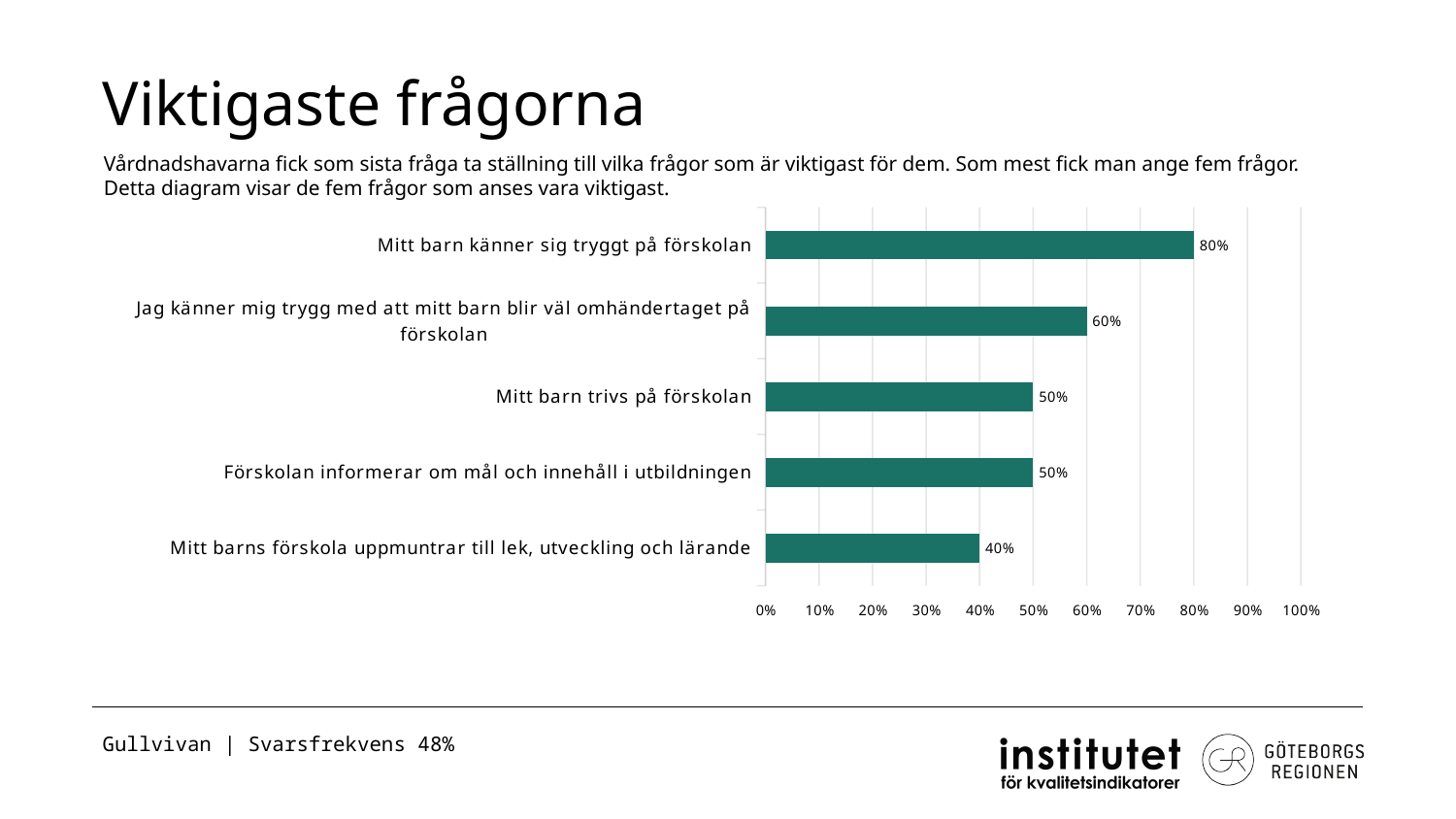
Which is larger: the value for "Jag känner mig trygg med att mitt barn blir väl omhändertaget på förskolan" or the value for "Mitt barns förskola uppmuntrar till lek, utveckling och lärande"? Jag känner mig trygg med att mitt barn blir väl omhändertaget på förskolan What is the value for "Jag känner mig trygg med att mitt barn blir väl omhändertaget på förskolan"? 60% What is the value for "Mitt barns förskola uppmuntrar till lek, utveckling och lärande"? 40% How many categories are shown in the chart? 5 Which category has the highest value? Mitt barn känner sig tryggt på förskolan What is the title of the slide? Viktigaste frågorna Which category has the lowest value? Mitt barns förskola uppmuntrar till lek, utveckling och lärande What is the value for "Förskolan informerar om mål och innehåll i utbildningen"? 50% What kind of chart is shown on the slide? Bar chart What is the value for "Mitt barn känner sig tryggt på förskolan"? 80% What is the maximum value shown on the x axis? 100% What is the difference between the values for "Mitt barn känner sig tryggt på förskolan" and "Mitt barn trivs på förskolan"? 30%